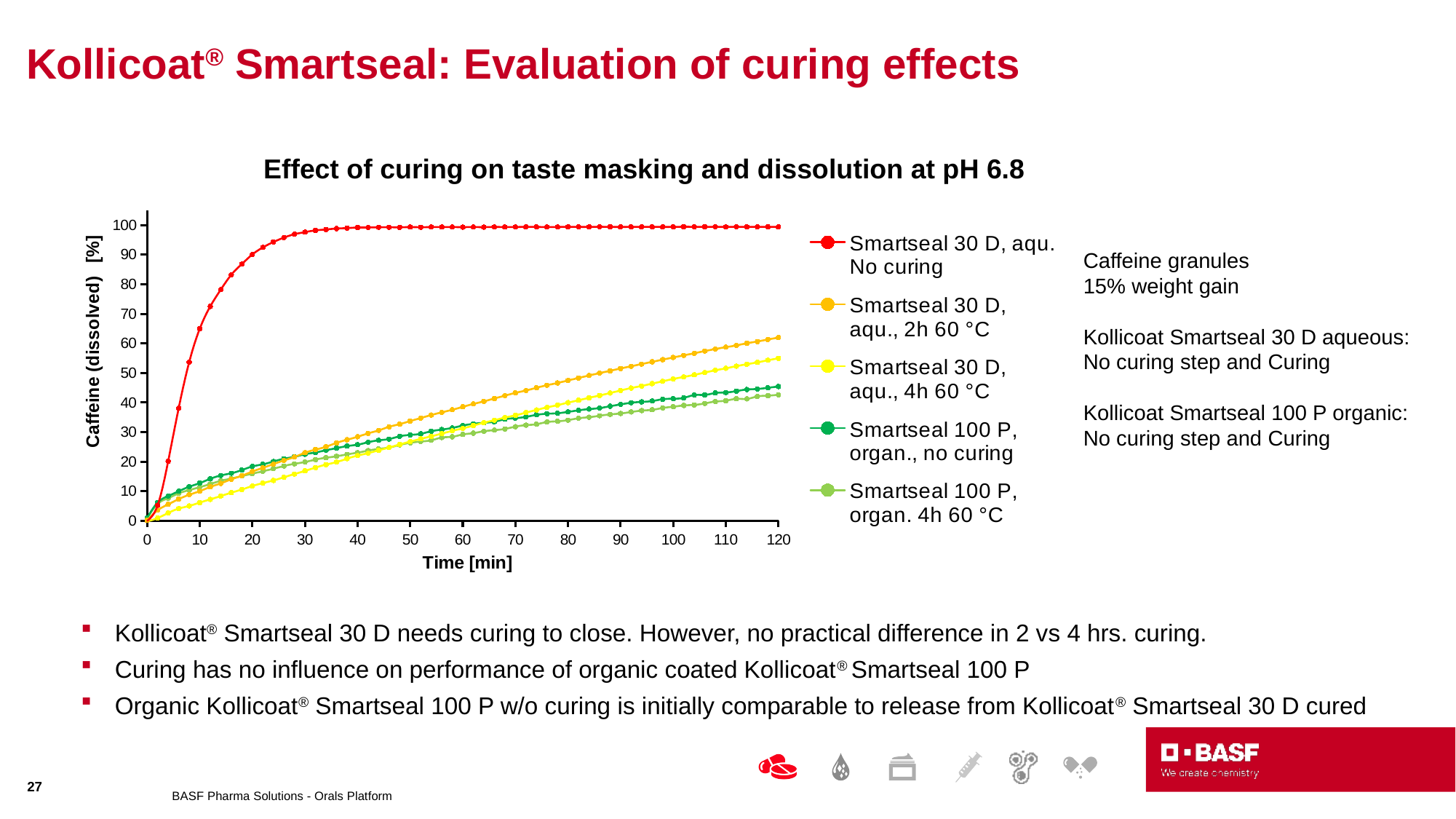
At 120 min, which is higher: Smartseal 30 D, aqu., 2h 60 °C or Smartseal 30 D, aqu., 4h 60 °C? Smartseal 30 D, aqu., 2h 60 °C Is the value for Smartseal 30 D, aqu., 4h 60 °C at 120 min greater or less than 60? less Which series has the highest caffeine dissolved value at 120 min? Smartseal 30 D, aqu. No curing Is the value for Smartseal 30 D, aqu., 2h 60 °C at 120 min greater or less than 50? greater What is the title of the chart? Effect of curing on taste masking and dissolution at pH 6.8 What is the label of the x axis of the chart? Time [min] Which series has the lowest caffeine dissolved value at 120 min? Smartseal 100 P, organ. 4h 60 °C What kind of chart is shown on the slide? Line chart Is the value for Smartseal 30 D, aqu. No curing at 120 min greater or less than 90? greater How many series does the chart legend list? 5 Does the Smartseal 30 D, aqu., 2h 60 °C series rise or fall as time increases? Rise